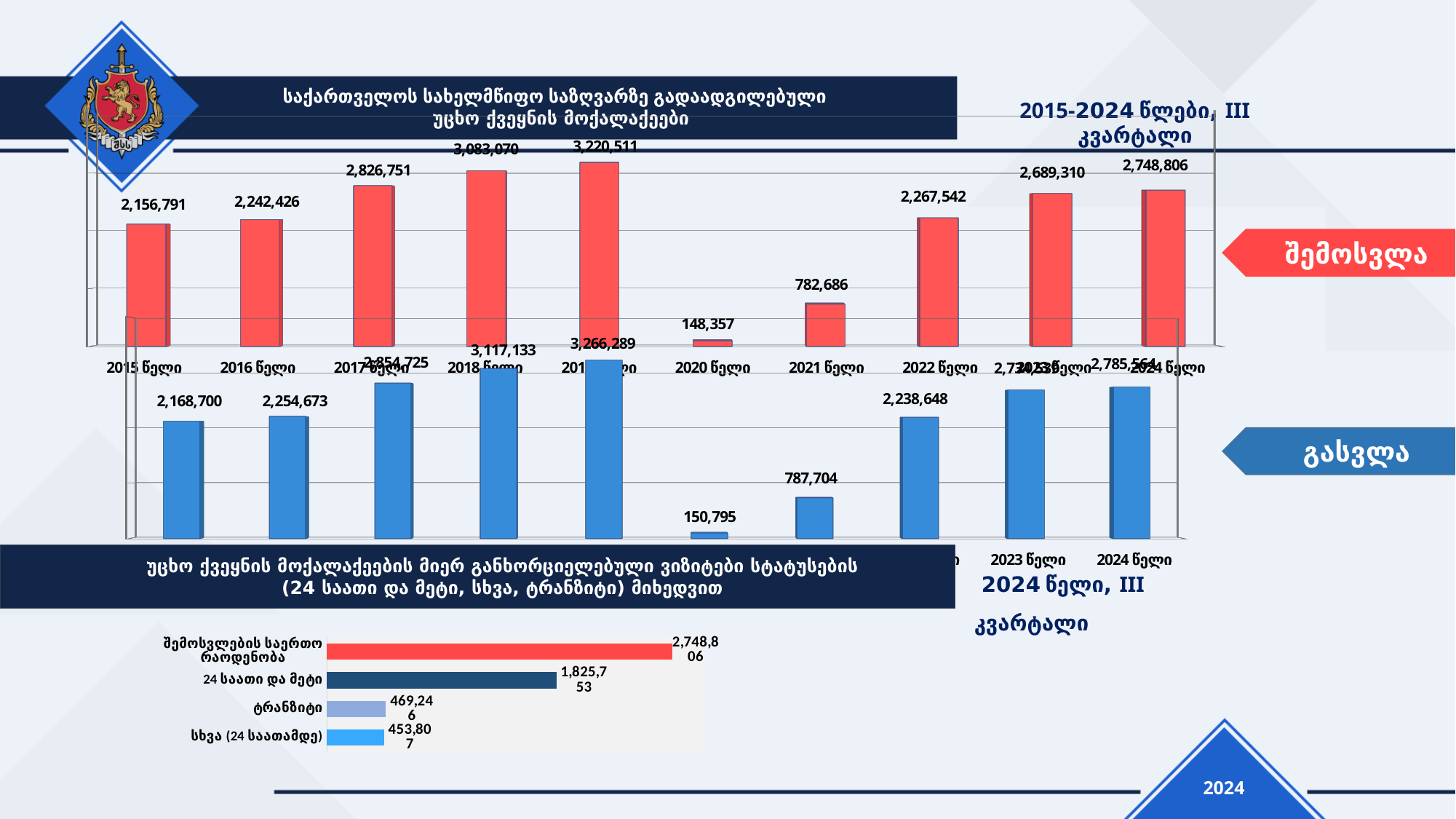
In the top red bar chart (შემოსვლა), which year has the lowest value? 2020 წელი In the middle blue bar chart (გასვლა), what is the value for 2020 წელი? 150,795 In the middle blue bar chart (გასვლა), which is larger: the value for 2021 წელი or 2022 წელი? 2022 წელი In the top red bar chart (შემოსვლა), which year has the highest value? 2019 წელი In the bottom horizontal bar chart, what is the value for ტრანზიტი? 469,246 In the middle blue bar chart (გასვლა), what is the value for 2018 წელი? 3,117,133 In the middle blue bar chart (გასვლა), what is the difference between the values for 2016 წელი and 2015 წელი? 85,973 In the top red bar chart (შემოსვლა), what is the value for 2019 წელი? 3,220,511 In the top red bar chart (შემოსვლა), how many years are shown? 10 In the bottom horizontal bar chart, which category has the smallest value? სხვა (24 საათამდე) In the top red bar chart (შემოსვლა), what is the difference between the values for 2024 წელი and 2023 წელი? 59,496 What type of chart is the bottom chart on the slide? Bar chart